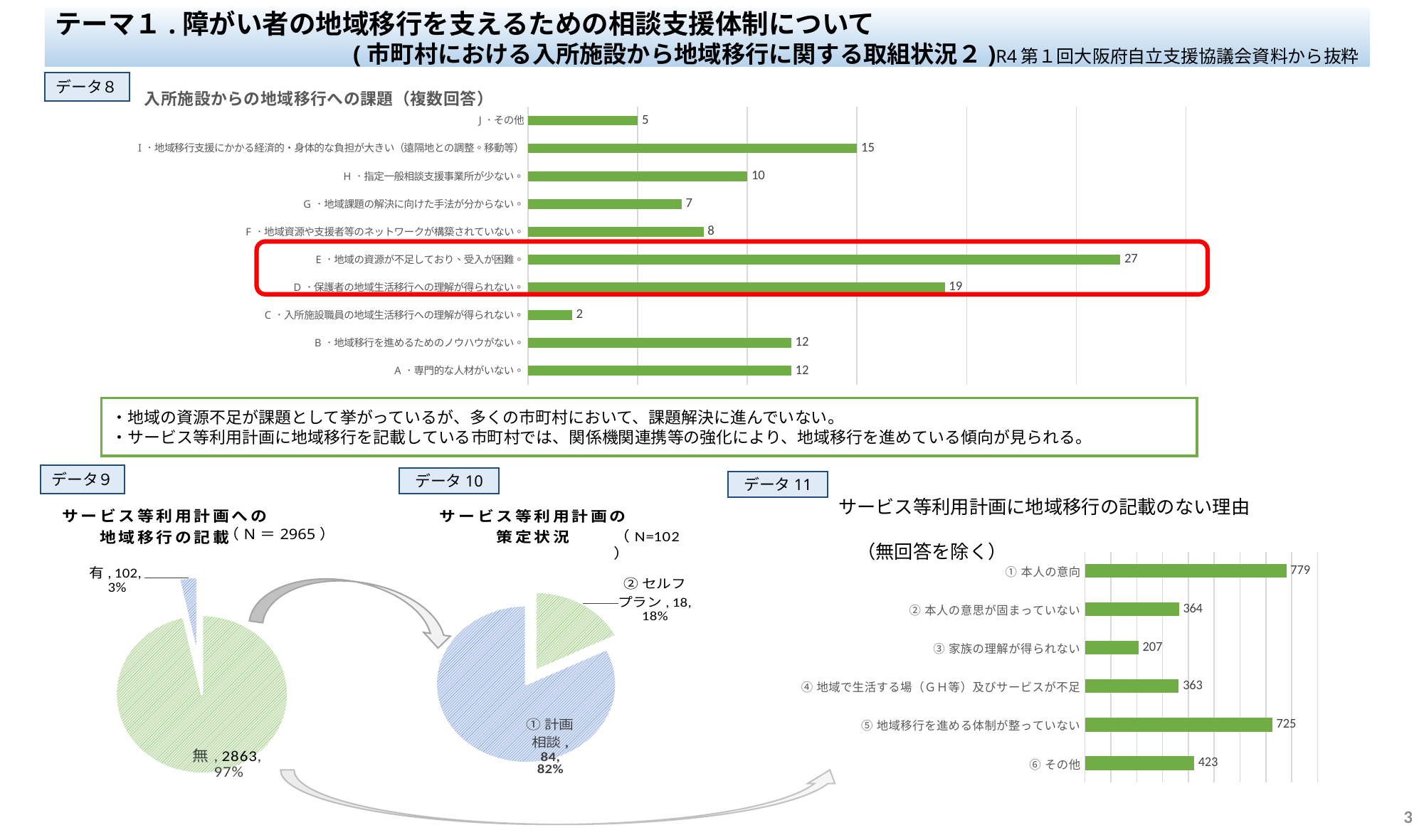
In the データ10 pie chart 「サービス等利用計画の策定状況」, what share does 「② セルフプラン」 have? 18% In the データ8 chart 「入所施設からの地域移行への課題（複数回答）」, what is the difference between the values for E and D? 8 In the データ8 chart 「入所施設からの地域移行への課題（複数回答）」, what is the value for 「E・地域の資源が不足しており、受入が困難。」? 27 In the データ8 chart 「入所施設からの地域移行への課題（複数回答）」, which is larger, the value for H or the value for I? I In the データ11 chart 「サービス等利用計画に地域移行の記載のない理由」, what is the difference between 「① 本人の意向」 and 「⑤ 地域移行を進める体制が整っていない」? 54 In the データ11 chart 「サービス等利用計画に地域移行の記載のない理由」, what is the value for 「③ 家族の理解が得られない」? 207 In the データ11 chart 「サービス等利用計画に地域移行の記載のない理由」, which category has the highest value? ① 本人の意向 In the データ8 chart 「入所施設からの地域移行への課題（複数回答）」, which category has the lowest value? C・入所施設職員の地域生活移行への理解が得られない。 What kind of chart is the データ9 chart 「サービス等利用計画への地域移行の記載」? Pie chart In the データ9 pie chart 「サービス等利用計画への地域移行の記載」, what is the value for 「無」? 2863 In the データ9 pie chart 「サービス等利用計画への地域移行の記載」, what share does 「有」 have? 3% In the データ8 chart 「入所施設からの地域移行への課題（複数回答）」, how many categories are plotted? 10